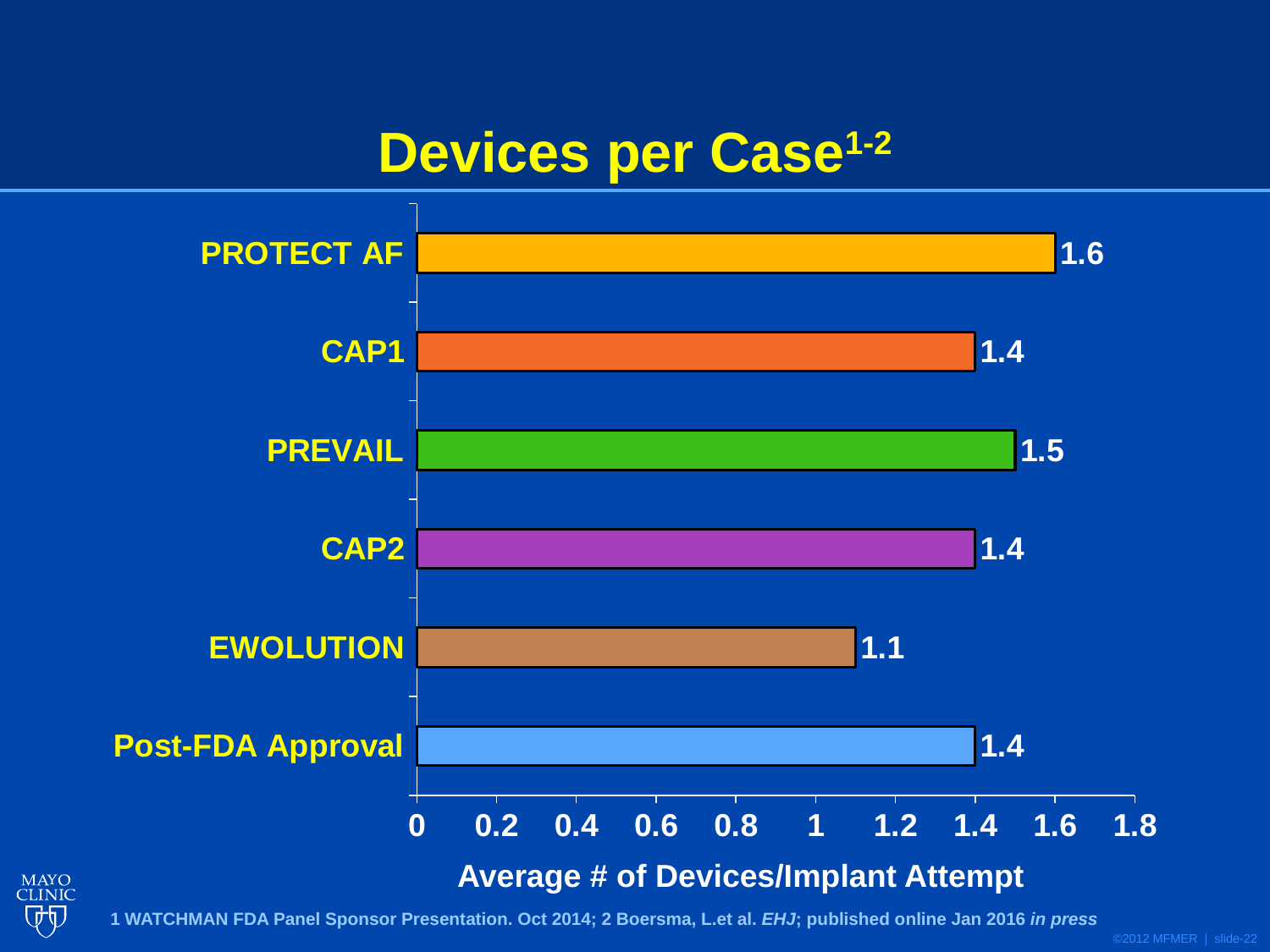
What kind of chart is shown on the slide? Bar chart What is the value shown for EWOLUTION? 1.1 How many studies are shown in the chart? 6 What is the value shown for Post-FDA Approval? 1.4 Which is larger, the value for PREVAIL or the value for CAP2? PREVAIL What is the label of the horizontal axis? Average # of Devices/Implant Attempt What is the value shown for PREVAIL? 1.5 What is the difference between the values for PREVAIL and CAP1? 0.1 Which study has the lowest average number of devices per implant attempt? EWOLUTION Which study has the highest average number of devices per implant attempt? PROTECT AF What is the average number of devices per implant attempt for PROTECT AF? 1.6 What is the difference between the values for PROTECT AF and EWOLUTION? 0.5